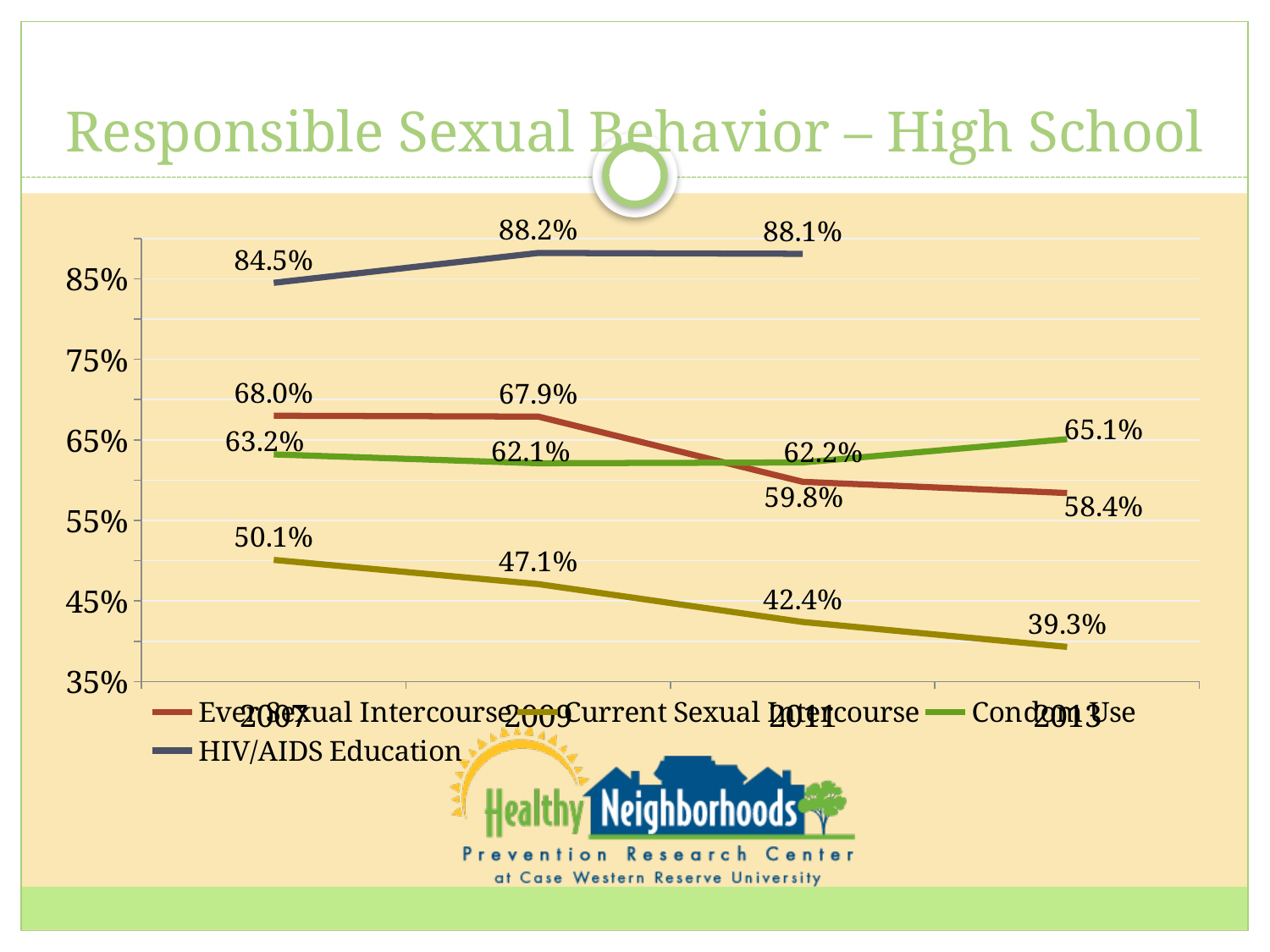
What is the value for HIV/AIDS Education in 2009? 88.2% What is the value for Ever Sexual Intercourse in 2011? 59.8% Does the Current Sexual Intercourse series rise or fall from 2007 to 2013? fall Which series has the lowest value in 2013? Current Sexual Intercourse How many years are shown on the x axis? 4 What is the value for Condom Use in 2007? 63.2% What is the value for Current Sexual Intercourse in 2013? 39.3% How many series does the legend list? 4 Which is larger in 2013, Condom Use or Ever Sexual Intercourse? Condom Use Which series has the highest values across the chart? HIV/AIDS Education What type of chart is shown on the slide? line chart What is the difference between the Current Sexual Intercourse values in 2007 and 2013? 10.8%